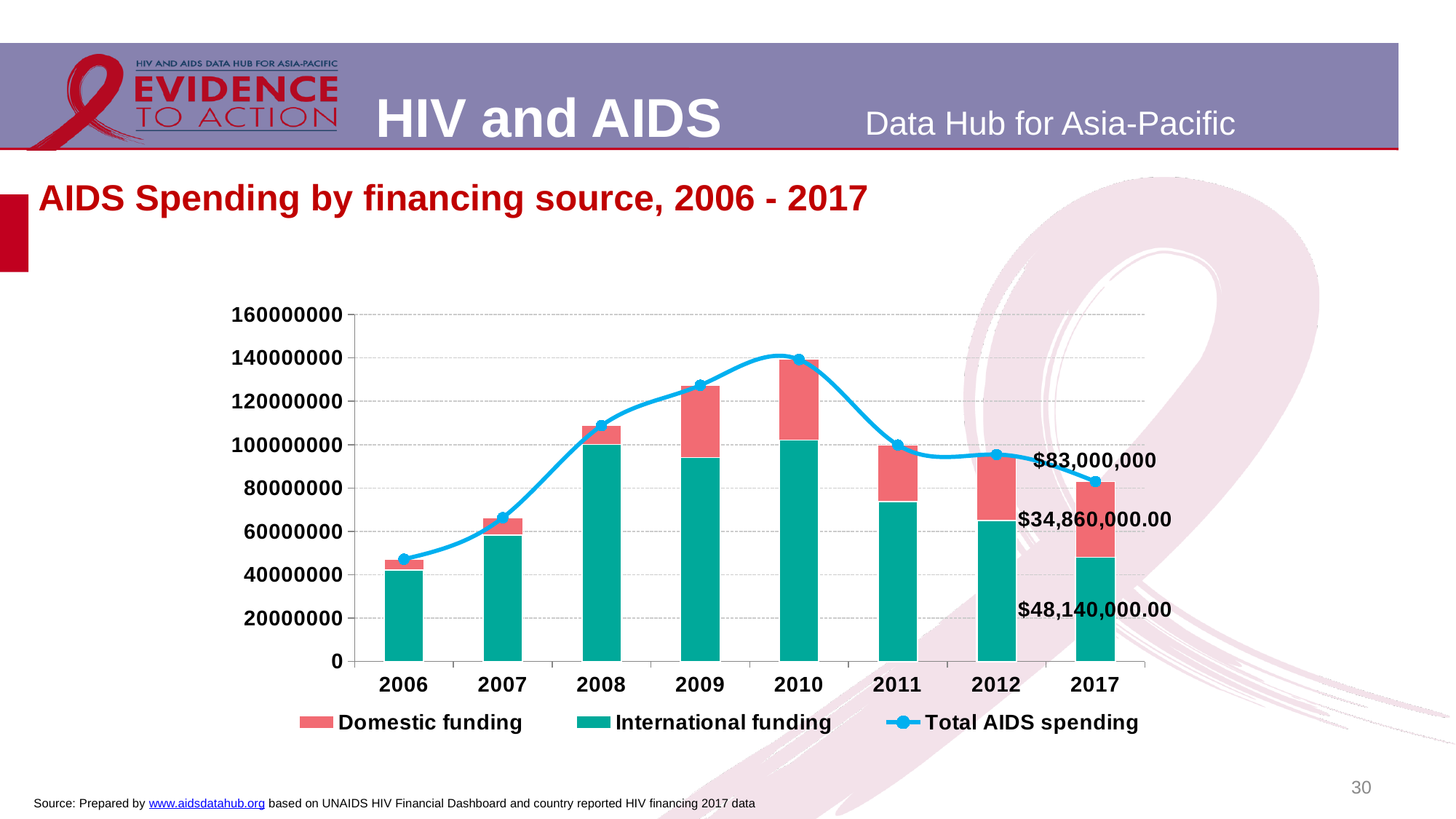
In which year is Total AIDS spending lowest? 2006 What is the difference between International funding and Domestic funding in 2017? $13,280,000.00 What kind of chart is shown on the slide? A stacked bar chart with a line In which year is Total AIDS spending highest? 2010 How many years are shown on the x axis? 8 How many series does the legend list? 3 Is the Total AIDS spending for 2010 greater or less than 120000000? greater What is the Total AIDS spending value labelled for 2017? $83,000,000 Is the International funding for 2006 greater or less than 60000000? less What is the International funding value labelled for 2017? $48,140,000.00 What is the Domestic funding value labelled for 2017? $34,860,000.00 In 2017, which is larger: International funding or Domestic funding? International funding